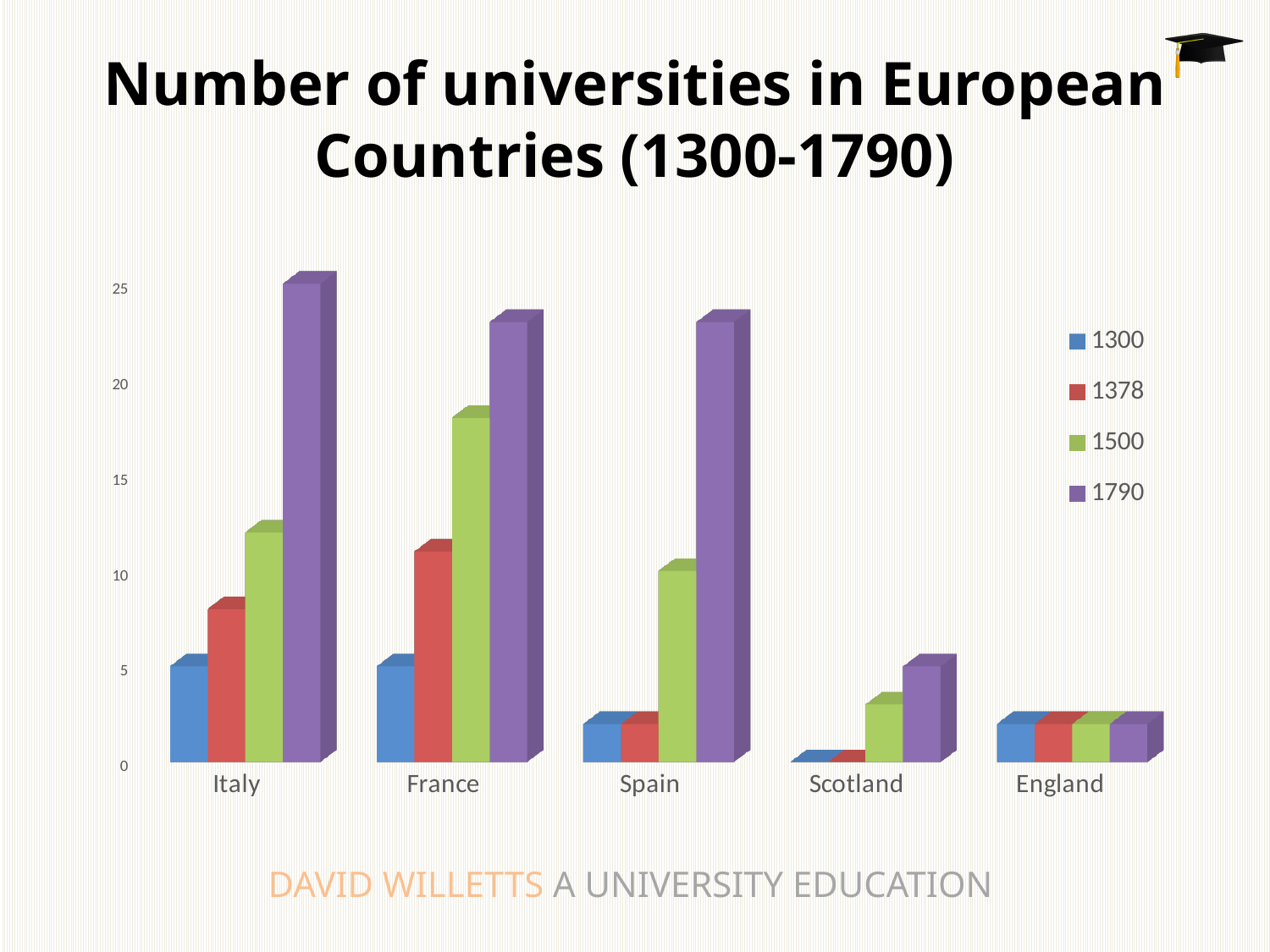
What kind of chart is shown on the slide? bar chart How many countries are shown on the x axis? 5 How many series does the legend list? 4 For Italy, do the values rise or fall from 1300 to 1790? rise What years are listed in the legend? 1300, 1378, 1500, 1790 Is the 1378 value for France greater or less than 10? greater Which is larger, the 1500 value for France or the 1500 value for Italy? France Which country has the highest value for 1500? France Is the 1300 value for Scotland greater or less than 5? less Is the 1790 value for Spain greater or less than 20? greater Which country has the highest value for 1790? Italy Which country has the lowest value for 1790? England